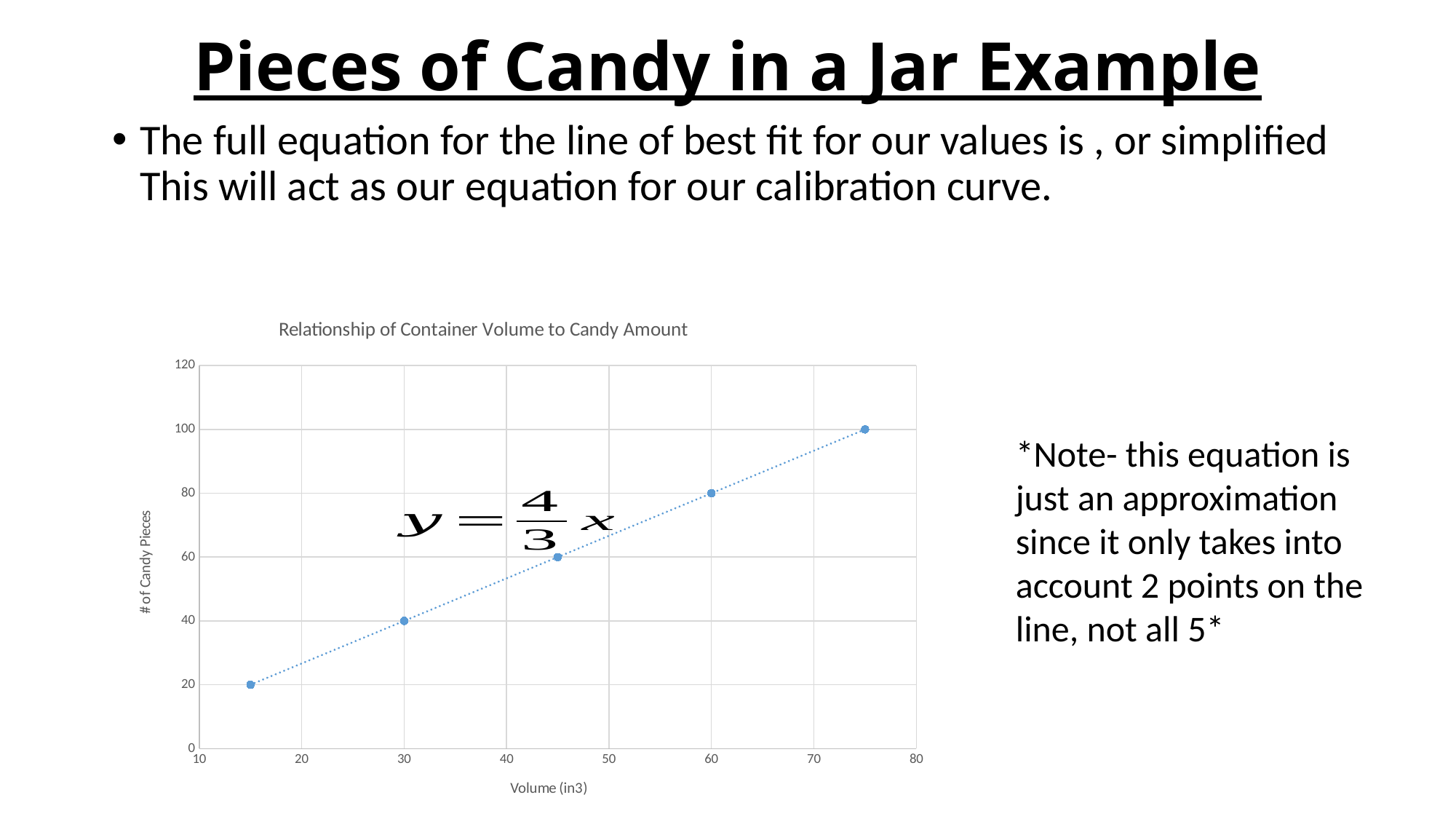
What kind of chart is shown on the slide? scatter chart What is the highest number of candy pieces plotted on the chart? 100 Do the number of candy pieces rise or fall as volume increases along the x axis? rise How many data points are plotted on the chart? 5 Which has more candy pieces: the point at volume 30 in3 or the point at volume 60 in3? 60 in3 Is the number of candy pieces for the rightmost point greater or less than 80? greater What is the difference between the highest and lowest number of candy pieces plotted? 80 What is the label of the x axis? Volume (in3) What is the lowest number of candy pieces plotted on the chart? 20 What is the number of candy pieces at a volume of 60 in3? 80 What is the number of candy pieces at a volume of 30 in3? 40 What is the title of the chart? Relationship of Container Volume to Candy Amount